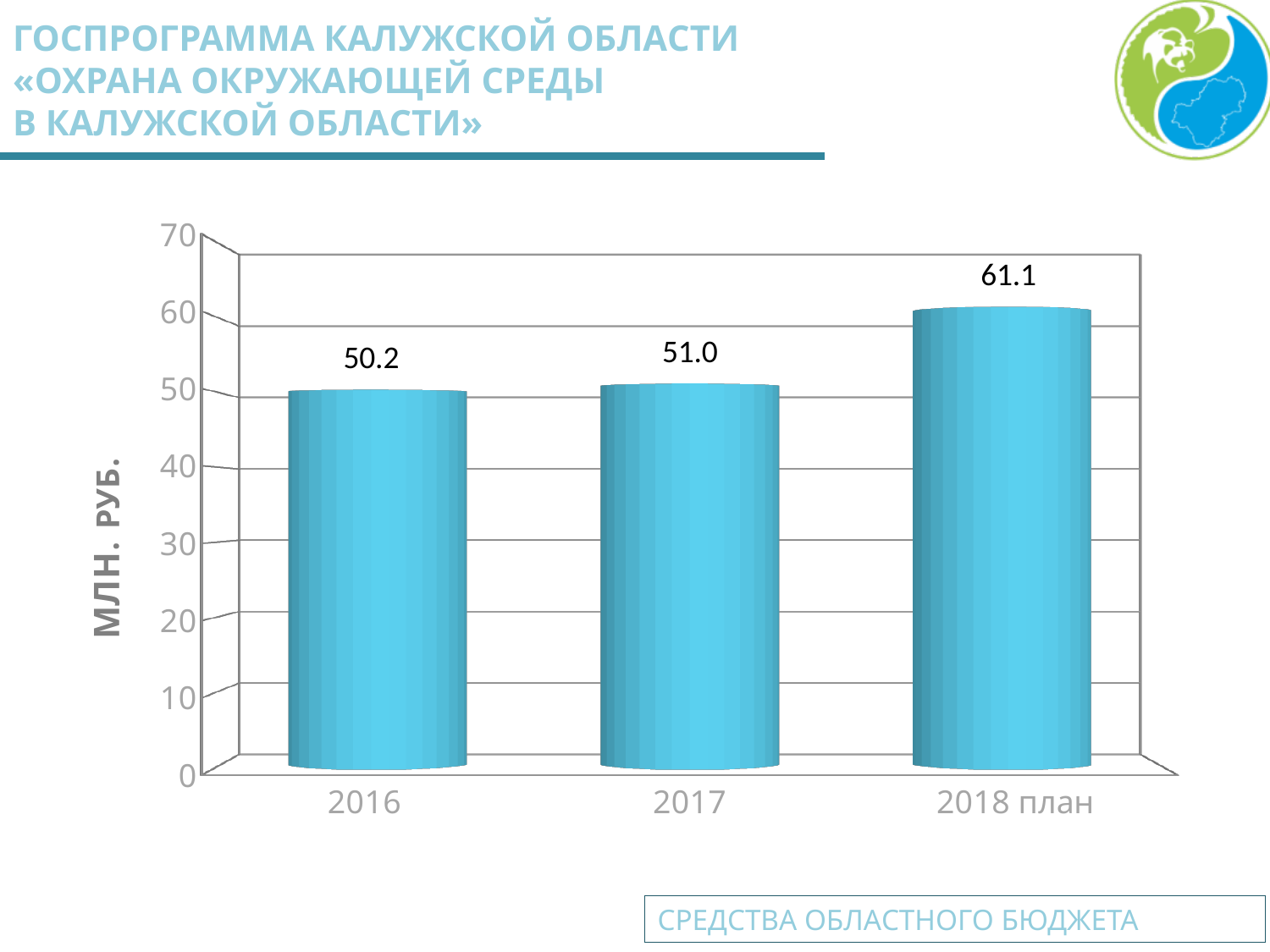
Do the values rise or fall from 2016 to 2018 план? rise What is the difference between the values for 2018 план and 2016? 10.9 What is the value for 2016? 50.2 Which category has the lowest value? 2016 What is the value for 2018 план? 61.1 Which is larger, the value for 2018 план or the value for 2017? 2018 план What is the value for 2017? 51.0 Is the value for 2018 план greater or less than 60? greater What kind of chart is shown on the slide? bar chart How many categories are shown on the x axis? 3 What is the difference between the values for 2017 and 2016? 0.8 Which category has the highest value? 2018 план